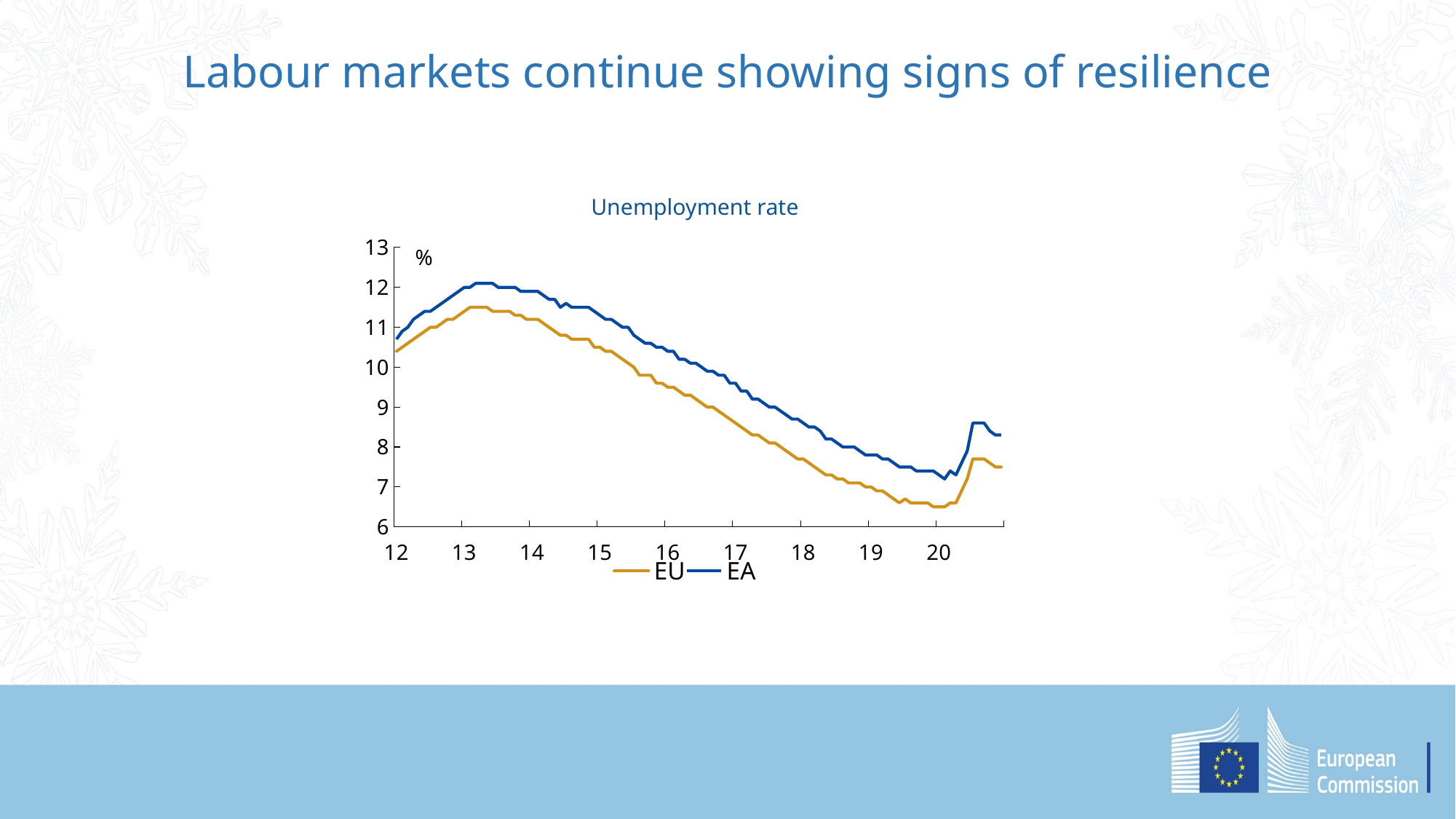
Is the EA unemployment rate at 18 greater or less than 9? less Is the EU unemployment rate at 13 greater or less than 11? greater Which series stays above the other across the whole period shown? EA Which series is drawn in blue? EA Which series has the higher unemployment rate at 17, EU or EA? EA What kind of chart is shown on the slide? line chart What is the title of the chart? Unemployment rate Does the EU unemployment rate rise or fall between 13 and 20? fall Is the EU unemployment rate at 20 greater or less than 7? less How many series does the legend list? 2